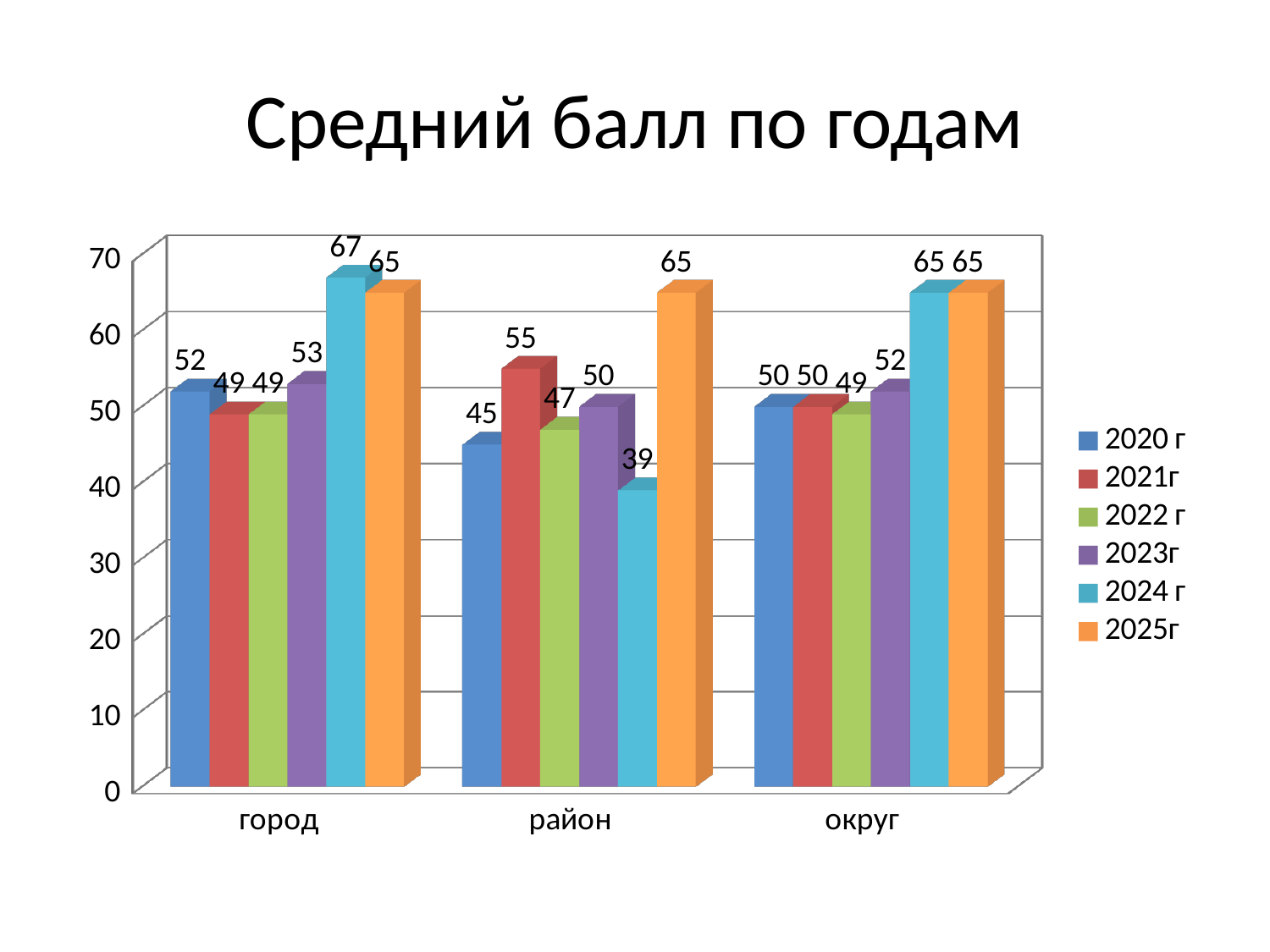
What is the value for 2024 г in the город category? 67 What is the value for 2023г in the округ category? 52 What is the value for 2020 г in the район category? 45 What is the difference between the 2025г and 2024 г values in the район category? 26 Which series has the lowest value in the район category? 2024 г Which is larger: the 2021г value for район or the 2021г value for город? район What is the title of the chart? Средний балл по годам What kind of chart is shown on the slide? bar chart What is the value for 2021г in the район category? 55 How many categories are shown on the x axis? 3 Which series has the highest value in the город category? 2024 г How many series does the legend list? 6